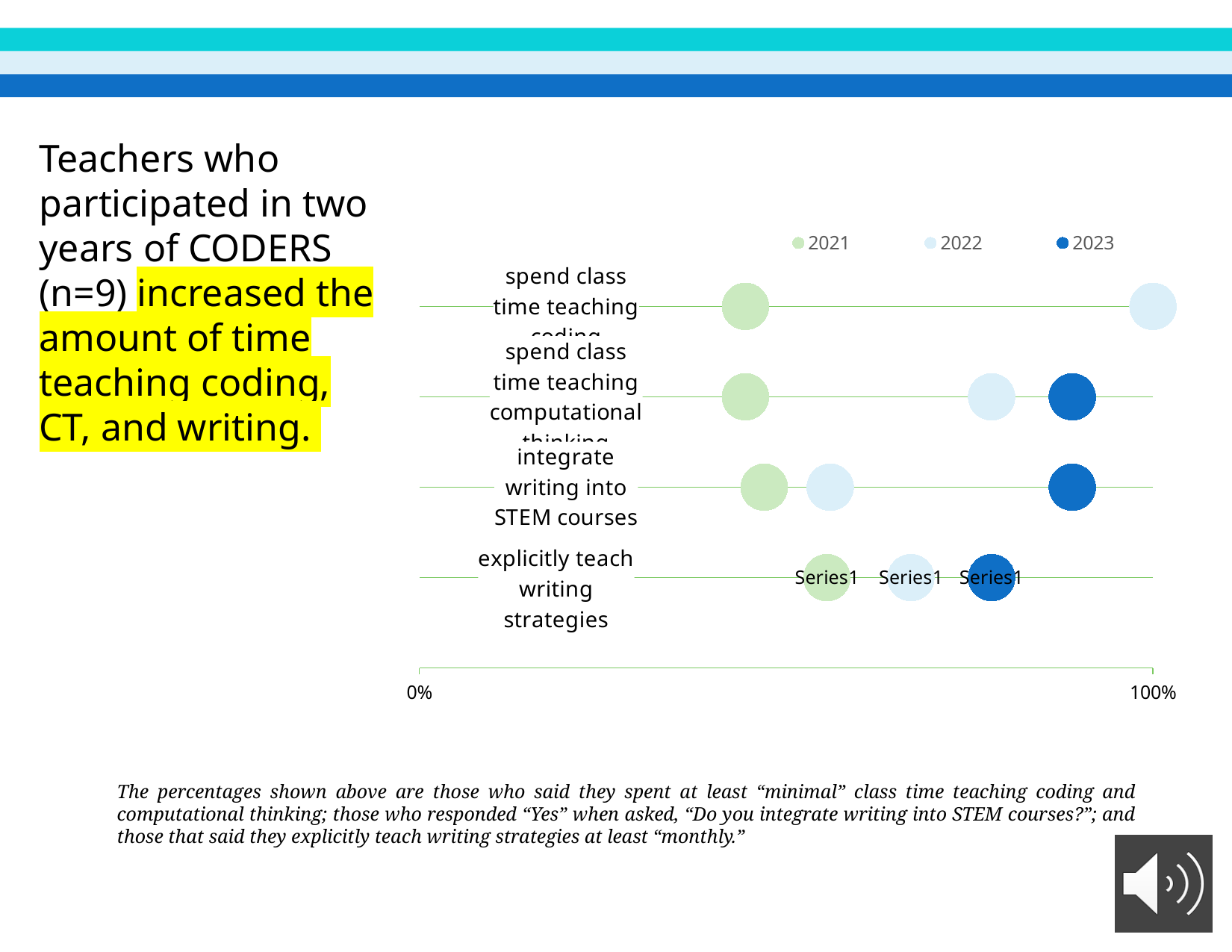
For 'integrate writing into STEM courses', which is larger: the 2022 value or the 2023 value? 2023 Which years are listed in the chart legend? 2021, 2022, 2023 What kind of chart is shown on the slide? Bubble chart How many series does the chart legend list? 3 For 'explicitly teach writing strategies', do the values rise or fall from 2021 to 2023? Rise For 'explicitly teach writing strategies', which year has the lowest value? 2021 For 'explicitly teach writing strategies', which is larger: the 2021 value or the 2023 value? 2023 How many categories are plotted on the chart's vertical axis? 4 Among the four categories, which has the lowest 2022 value? integrate writing into STEM courses Which series is shown in dark blue in the chart? 2023 Among the four categories, which has the highest 2022 value? spend class time teaching coding For 'spend class time teaching computational thinking', which year has the highest value? 2023